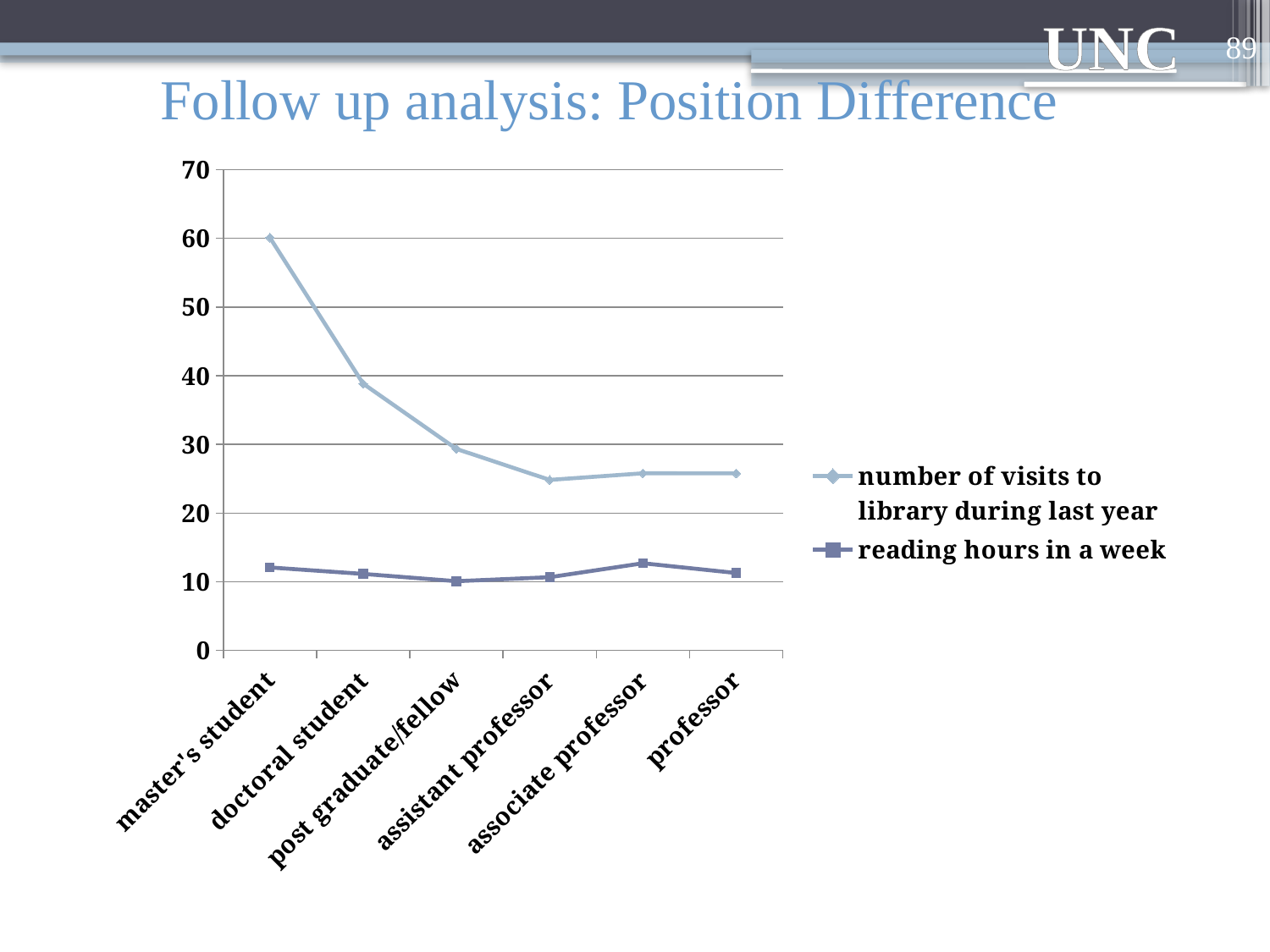
Is the number of visits to library during last year for assistant professor greater or less than 30? less How many position categories are shown on the x axis? 6 Is the number of visits to library during last year for doctoral student greater or less than 50? less Which position has the highest number of visits to library during last year? master's student Which has more visits to library during last year: master's student or doctoral student? master's student What is the title of the slide containing the chart? Follow up analysis: Position Difference Is the value for reading hours in a week for professor greater or less than 20? less Does the number of visits to library during last year rise or fall from master's student to assistant professor? fall Which is larger for professor: number of visits to library during last year or reading hours in a week? number of visits to library during last year What kind of chart is shown on the slide? line chart How many series does the legend list? 2